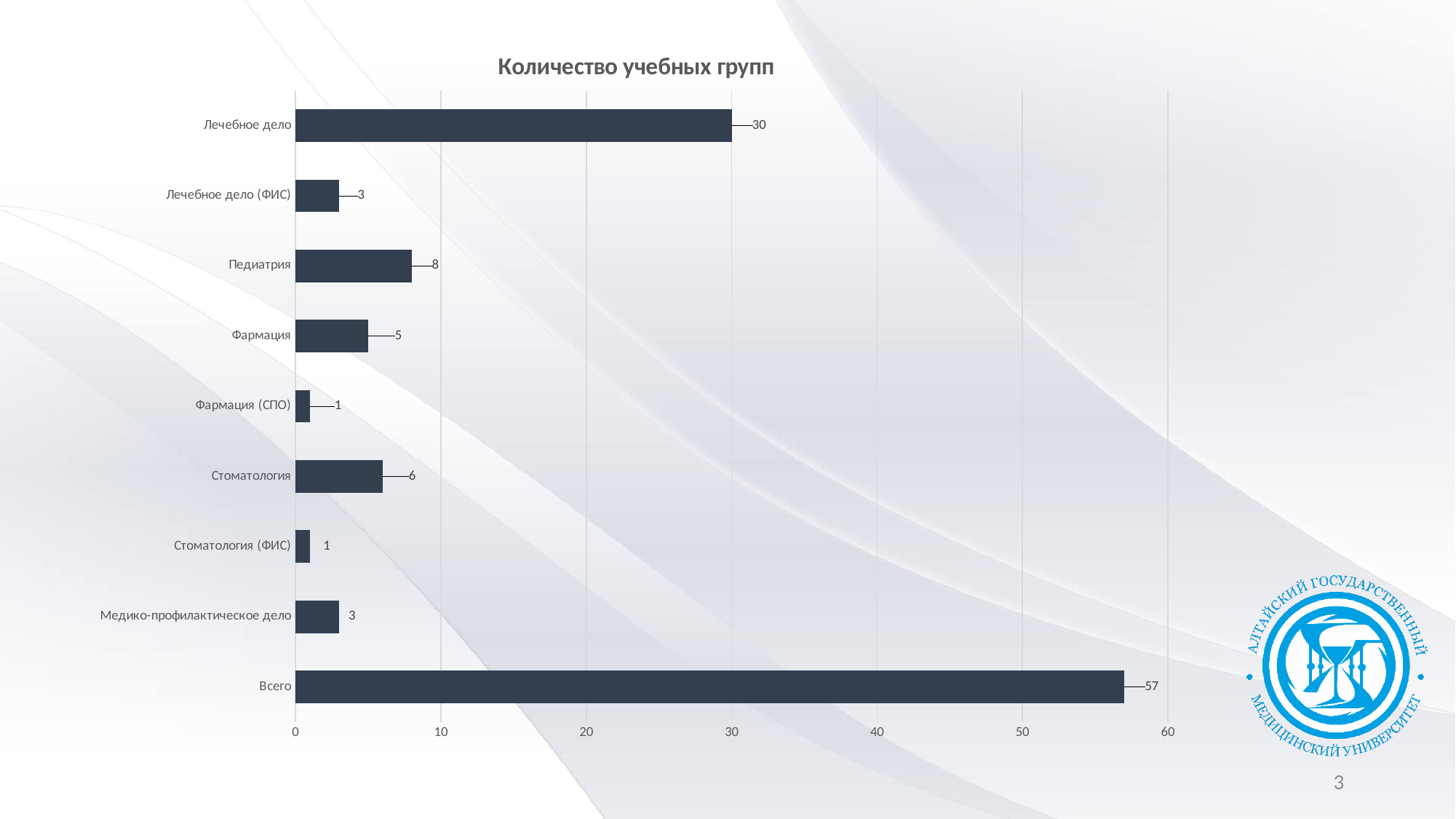
Which is larger, the value for Стоматология or the value for Фармация? Стоматология What kind of chart is shown on the slide? bar chart What is the value for Медико-профилактическое дело? 3 Is the value for Всего greater or less than 50? greater What is the difference between the values for Лечебное дело and Педиатрия? 22 Which categories have the lowest value? Фармация (СПО) and Стоматология (ФИС) Excluding the Всего bar, which category has the highest value? Лечебное дело What is the title of the chart? Количество учебных групп What is the value for Лечебное дело? 30 How many categories are shown on the chart? 9 What is the value for Педиатрия? 8 What is the value for Всего? 57